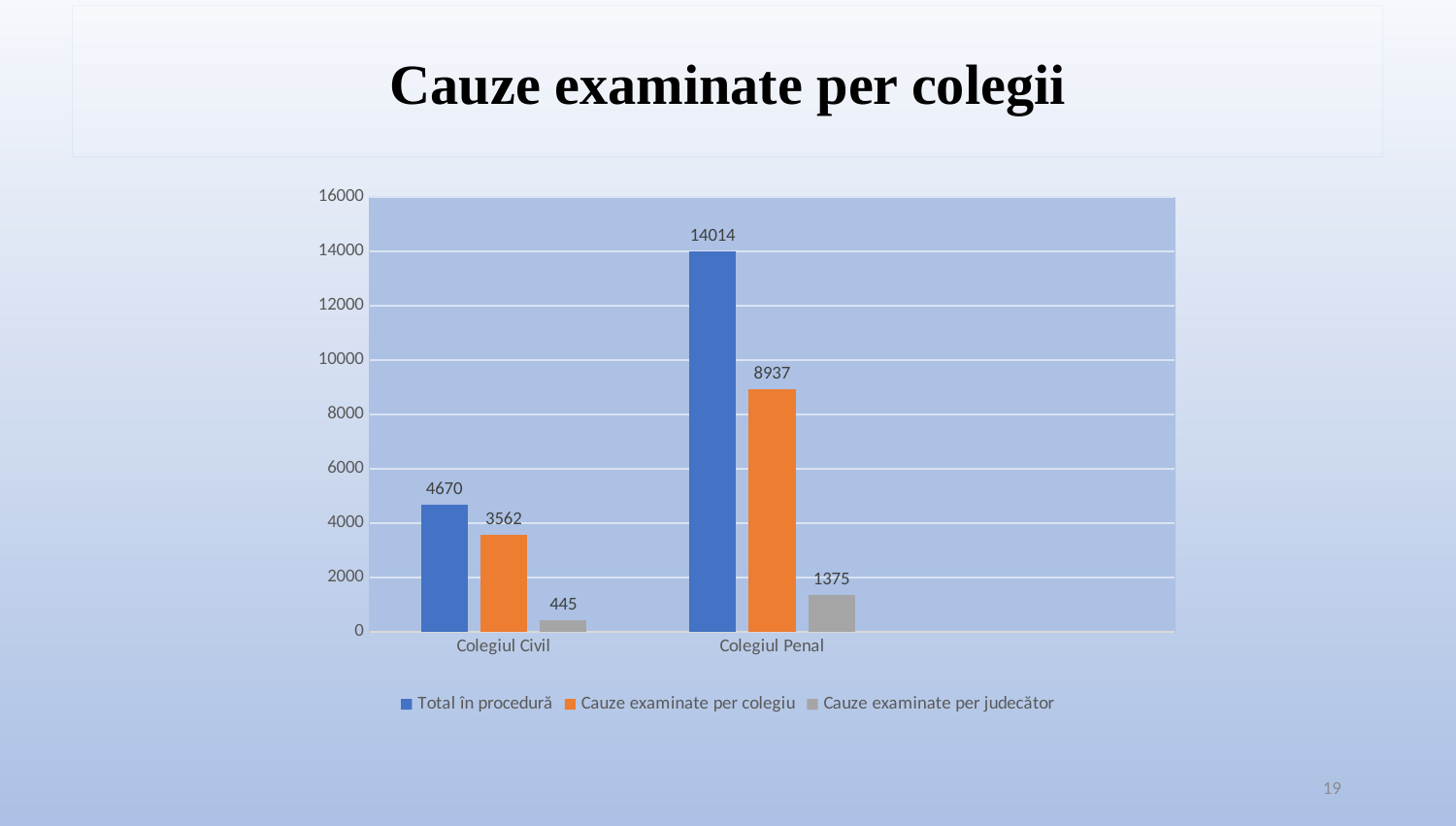
Is the 'Cauze examinate per colegiu' value for Colegiul Penal greater or less than 8000? greater Which category has the lowest 'Cauze examinate per judecător' value? Colegiul Civil What is the value of 'Total în procedură' for Colegiul Civil? 4670 What is the value of 'Cauze examinate per judecător' for Colegiul Civil? 445 What is the difference between 'Total în procedură' for Colegiul Penal and Colegiul Civil? 9344 How many series does the legend list? 3 Which is larger: 'Cauze examinate per colegiu' for Colegiul Civil or 'Cauze examinate per judecător' for Colegiul Penal? Cauze examinate per colegiu for Colegiul Civil What kind of chart is shown on the slide? bar chart Which category has the highest 'Total în procedură' value? Colegiul Penal What is the value of 'Cauze examinate per colegiu' for Colegiul Penal? 8937 How many categories are shown on the x axis? 2 What is the value of 'Total în procedură' for Colegiul Penal? 14014